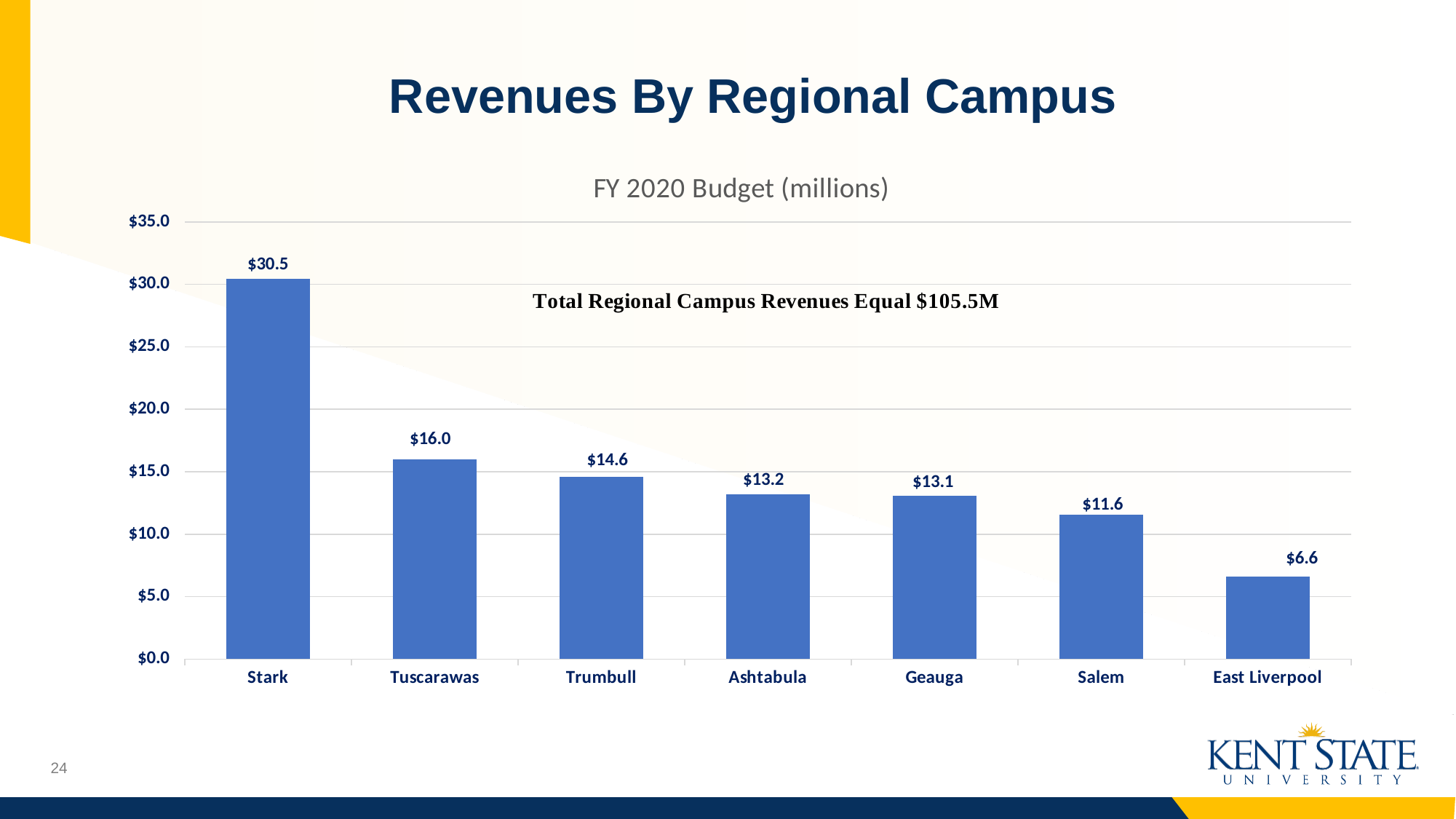
How many campuses are shown in the chart? 7 Which campus has the highest FY 2020 budget revenue? Stark What is the difference between the revenues of Trumbull and East Liverpool? $8.0 What is the FY 2020 budget revenue for the Salem campus? $11.6 Which campus has a larger revenue, Tuscarawas or Salem? Tuscarawas What is the FY 2020 budget revenue for the Geauga campus? $13.1 What is the difference between the revenues of Stark and Tuscarawas? $14.5 What is the chart's title? FY 2020 Budget (millions) What is the FY 2020 budget revenue for the Stark campus? $30.5 What kind of chart is shown on the slide? Bar chart Which campus has the lowest FY 2020 budget revenue? East Liverpool Is the value for Trumbull greater or less than $15.0? less